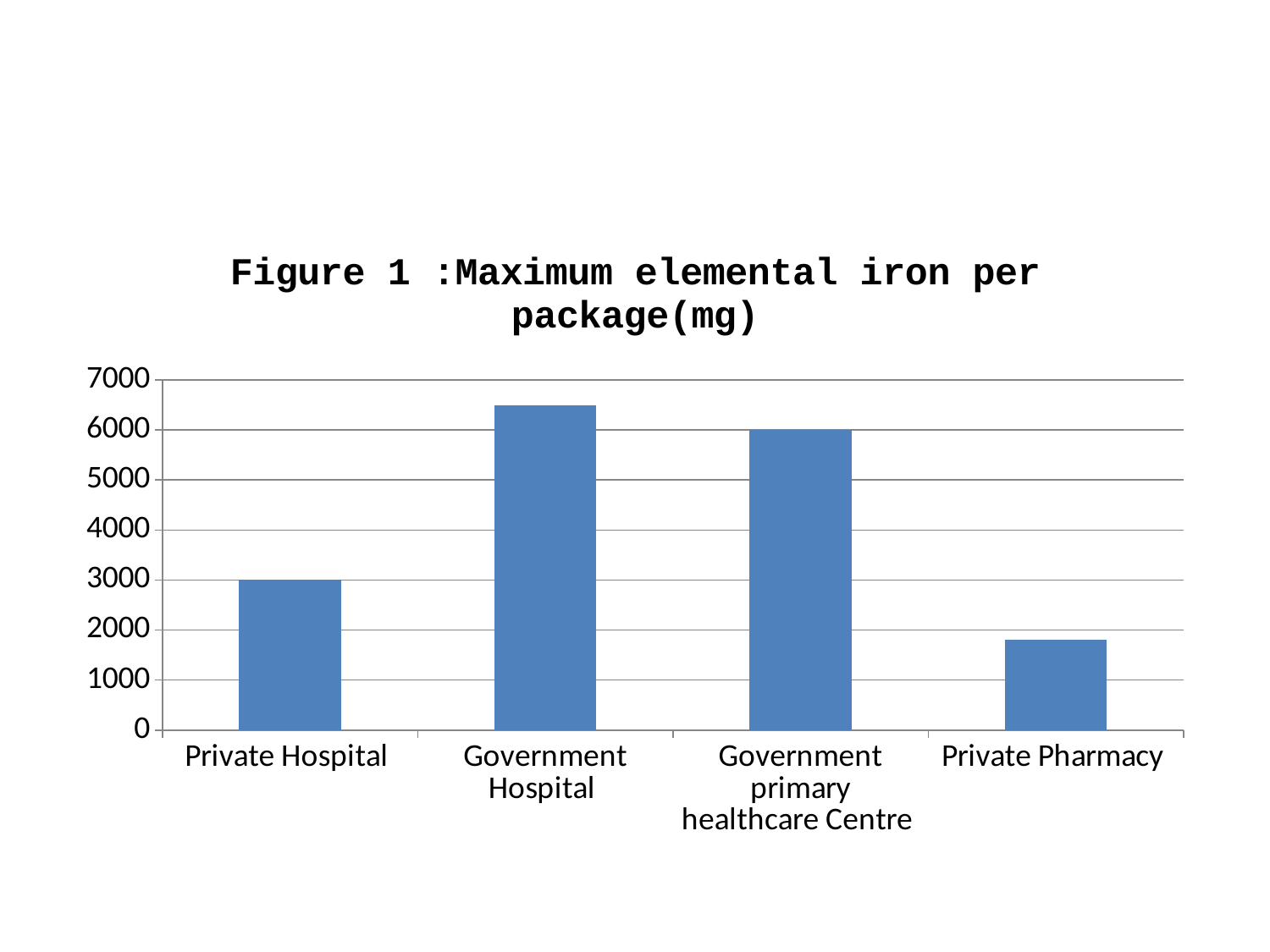
Is the value for Government Hospital greater or less than 6000? greater What is the difference between the value for Government primary healthcare Centre and the value for Private Hospital? 3000 What is the value for Government primary healthcare Centre? 6000 How many categories are shown on the x axis of the chart? 4 Which category has the lowest maximum elemental iron per package? Private Pharmacy What is the value for Private Hospital? 3000 What is the title of the chart? Figure 1 :Maximum elemental iron per package(mg) What kind of chart is shown on the slide? bar chart Is the value for Private Pharmacy greater or less than 1000? greater Which category has the highest maximum elemental iron per package? Government Hospital Is the value for Private Pharmacy greater or less than 2000? less Which is larger, the value for Government Hospital or the value for Government primary healthcare Centre? Government Hospital